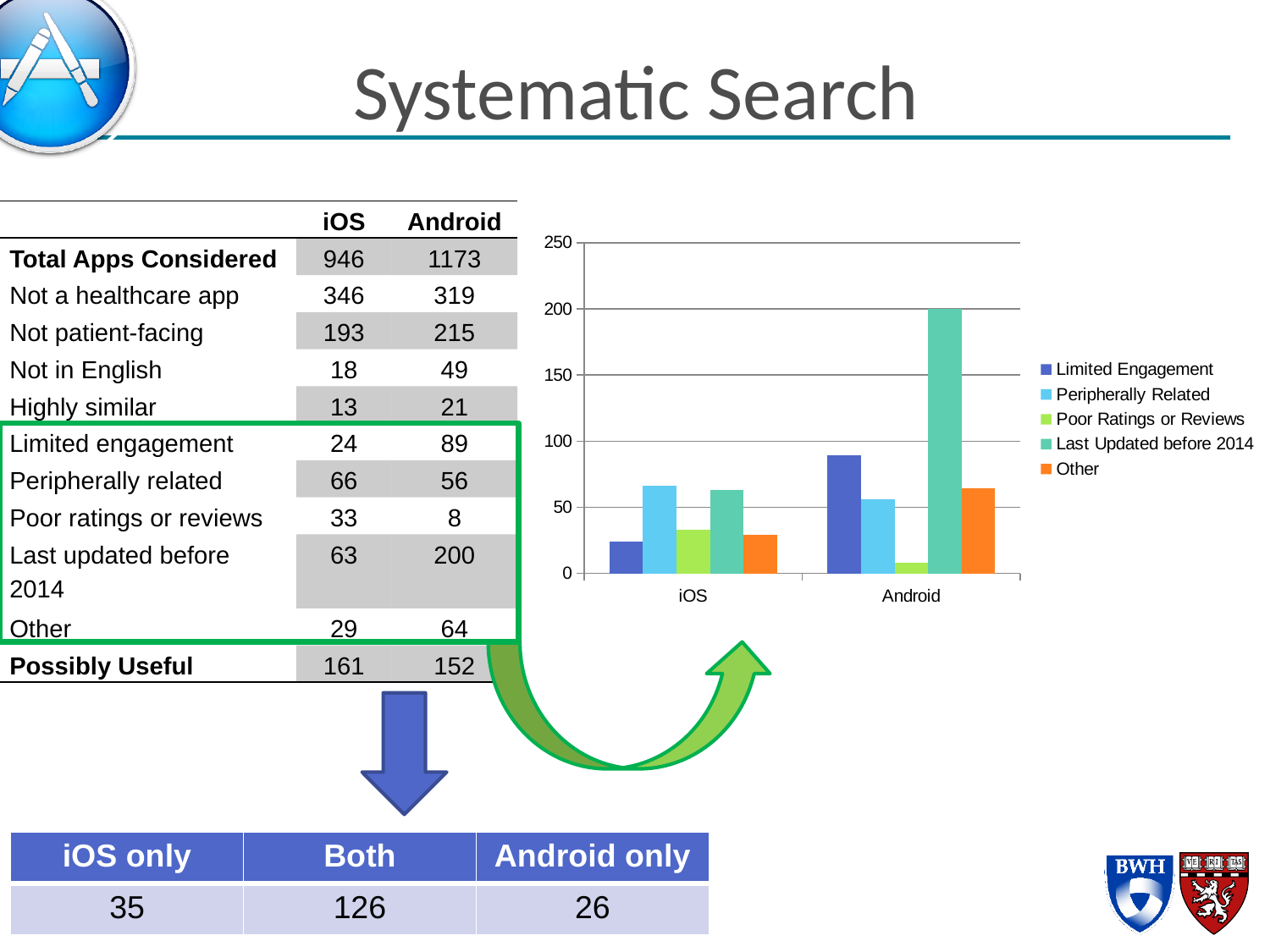
Which series has the shortest bar in the Android group? Poor Ratings or Reviews What is the value of the Last Updated before 2014 bar for Android? 200 How many series does the chart's legend list? 5 How many categories are shown on the x axis of the chart? 2 For the Poor Ratings or Reviews series, which platform has the larger value, iOS or Android? iOS Which series has the tallest bar in the Android group? Last Updated before 2014 Is the Other value for Android greater or less than 50? greater What colour represents the Other series in the chart? orange For the Limited Engagement series, which platform has the larger value, iOS or Android? Android Is the Limited Engagement value for iOS greater or less than 50? less What kind of chart is shown on the slide? bar chart Is the Limited Engagement value for Android greater or less than 50? greater